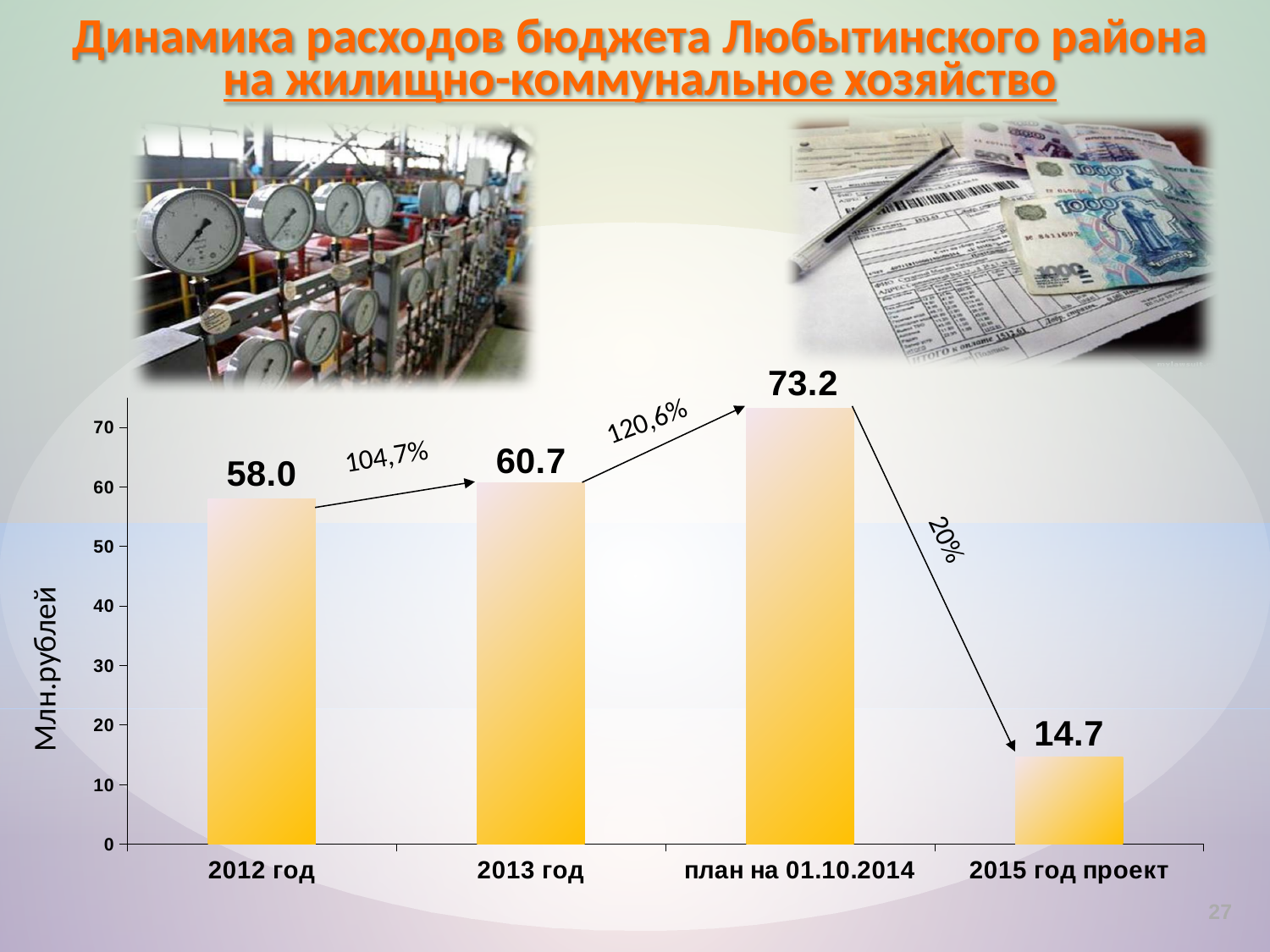
What is the value for план на 01.10.2014? 73.2 Which category has the highest value? план на 01.10.2014 What is the difference between the values for 2013 год and 2012 год? 2.7 What is the label on the vertical axis? Млн.рублей Which category has the lowest value? 2015 год проект What kind of chart is shown on the slide? bar chart What is the value for 2013 год? 60.7 Which is larger, the value for 2012 год or the value for 2013 год? 2013 год What is the value for 2012 год? 58.0 What is the value for 2015 год проект? 14.7 What is the difference between the values for план на 01.10.2014 and 2015 год проект? 58.5 How many categories are shown on the x axis? 4